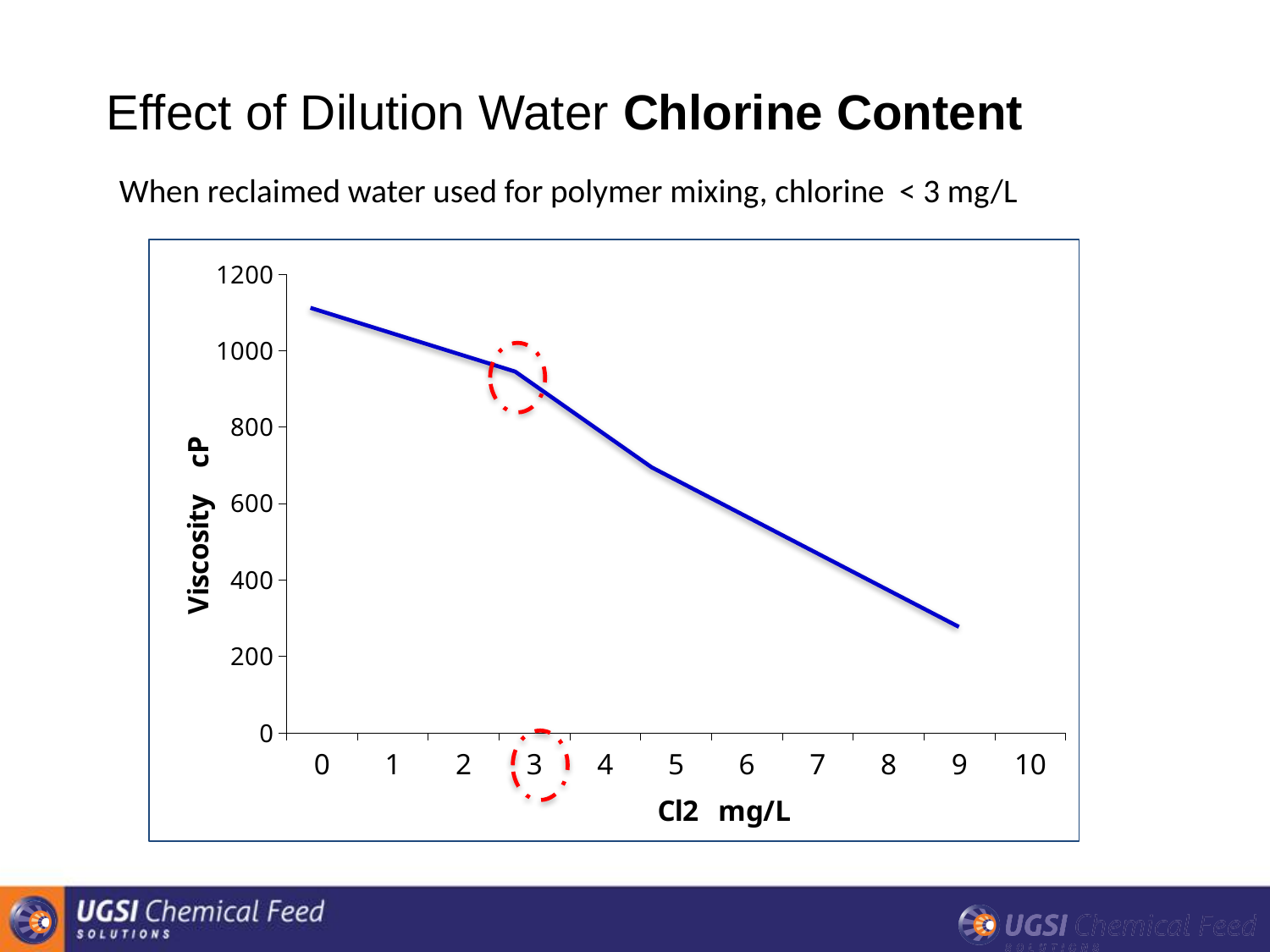
How many tick labels are shown on the x axis? 11 At which Cl2 concentration shown is the viscosity highest? 0 mg/L Which has the higher viscosity, 0 mg/L Cl2 or 9 mg/L Cl2? 0 mg/L Is the viscosity at 5 mg/L Cl2 greater or less than 800 cP? less Is the viscosity at 7 mg/L Cl2 greater or less than 600 cP? less Is the viscosity at 2 mg/L Cl2 greater or less than 800 cP? greater What is the label of the x axis? Cl2 mg/L What is the label of the y axis? Viscosity cP Does viscosity rise or fall as Cl2 concentration increases along the x axis? fall What kind of chart is shown on the slide? line chart